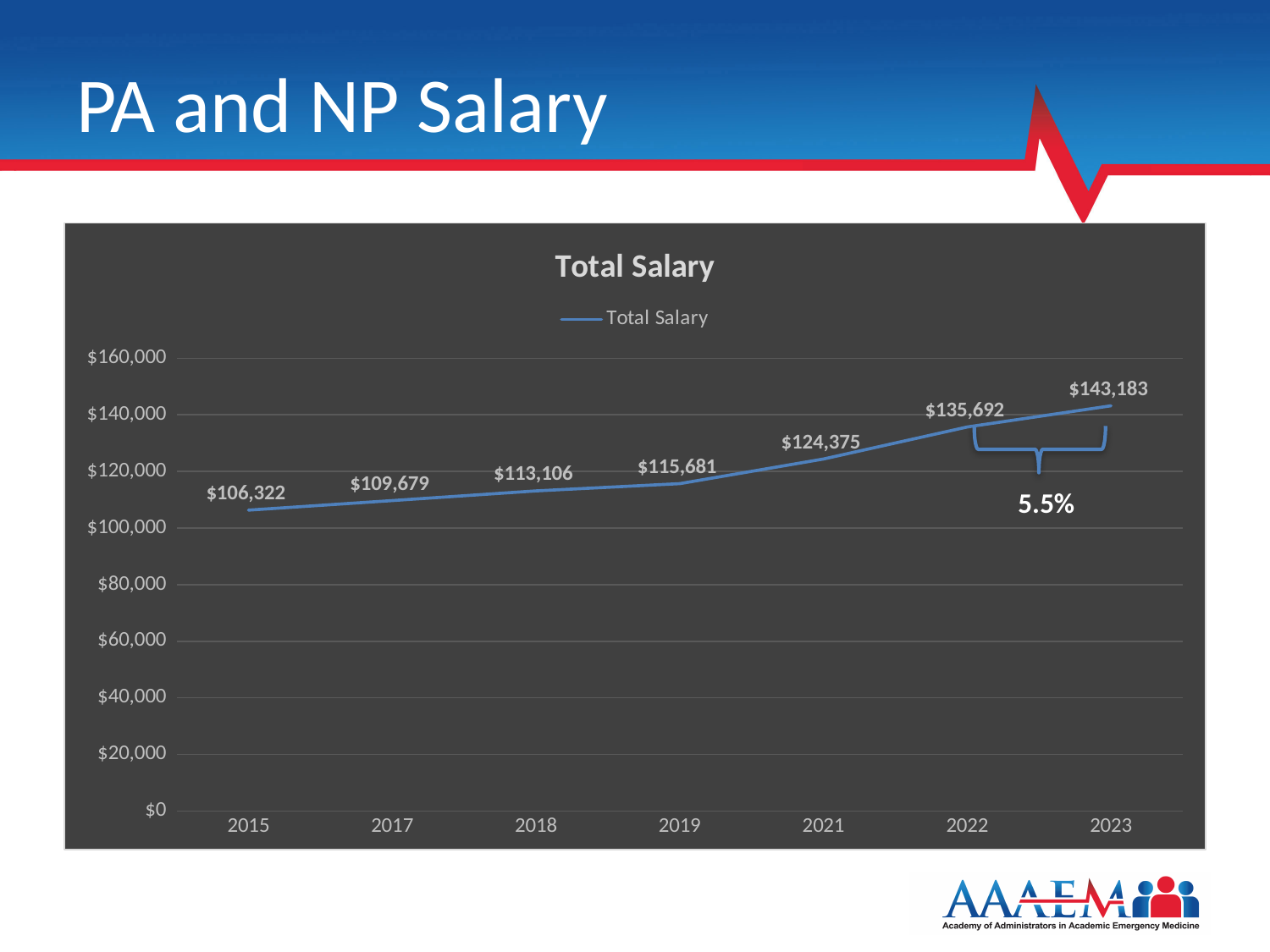
Does the Total Salary rise or fall from 2015 to 2023? Rise Which year has the lowest Total Salary? 2015 Which year has the highest Total Salary? 2023 What is the difference between the Total Salary in 2023 and in 2022? $7,491 Is the Total Salary for 2022 greater or less than $120,000? greater What is the Total Salary value for 2021? $124,375 What is the Total Salary value for 2023? $143,183 What is the difference between the Total Salary in 2019 and in 2015? $9,359 What is the Total Salary value for 2015? $106,322 Which is larger, the Total Salary in 2018 or in 2021? 2021 How many years are plotted on the x axis? 7 What kind of chart is shown on the slide? Line chart